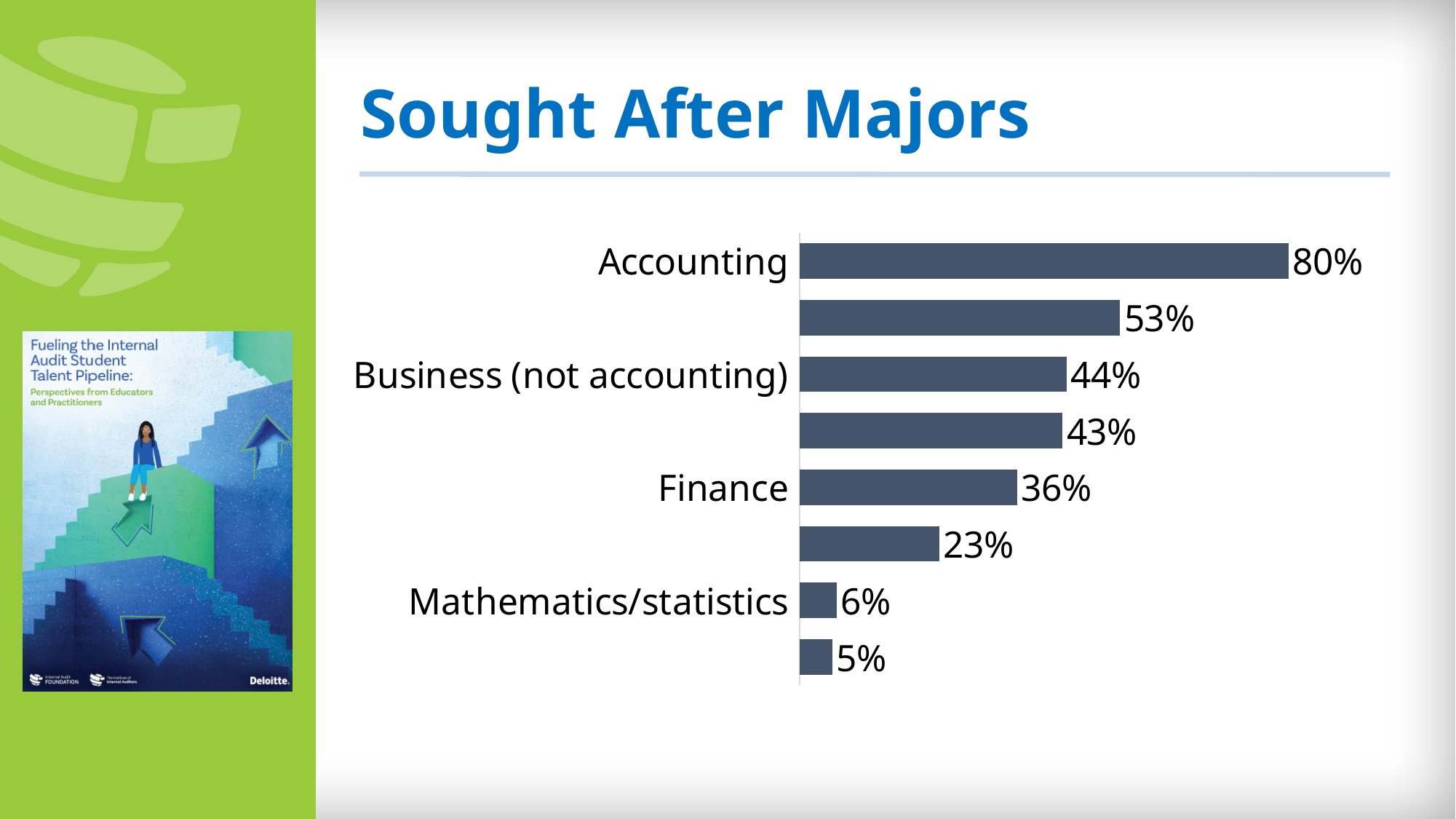
What is the lowest value shown on the chart? 5% How many bars are shown on the chart? 8 Which is larger, the value for Finance or the value for Mathematics/statistics? Finance What is the difference between the values for Business (not accounting) and Finance? 8% Which major has the highest value? Accounting What is the value for Accounting? 80% What is the difference between the values for Accounting and Finance? 44% What is the value for Finance? 36% What kind of chart is shown on the slide? bar chart What is the value for Business (not accounting)? 44% What is the title of the slide? Sought After Majors What is the value for Mathematics/statistics? 6%